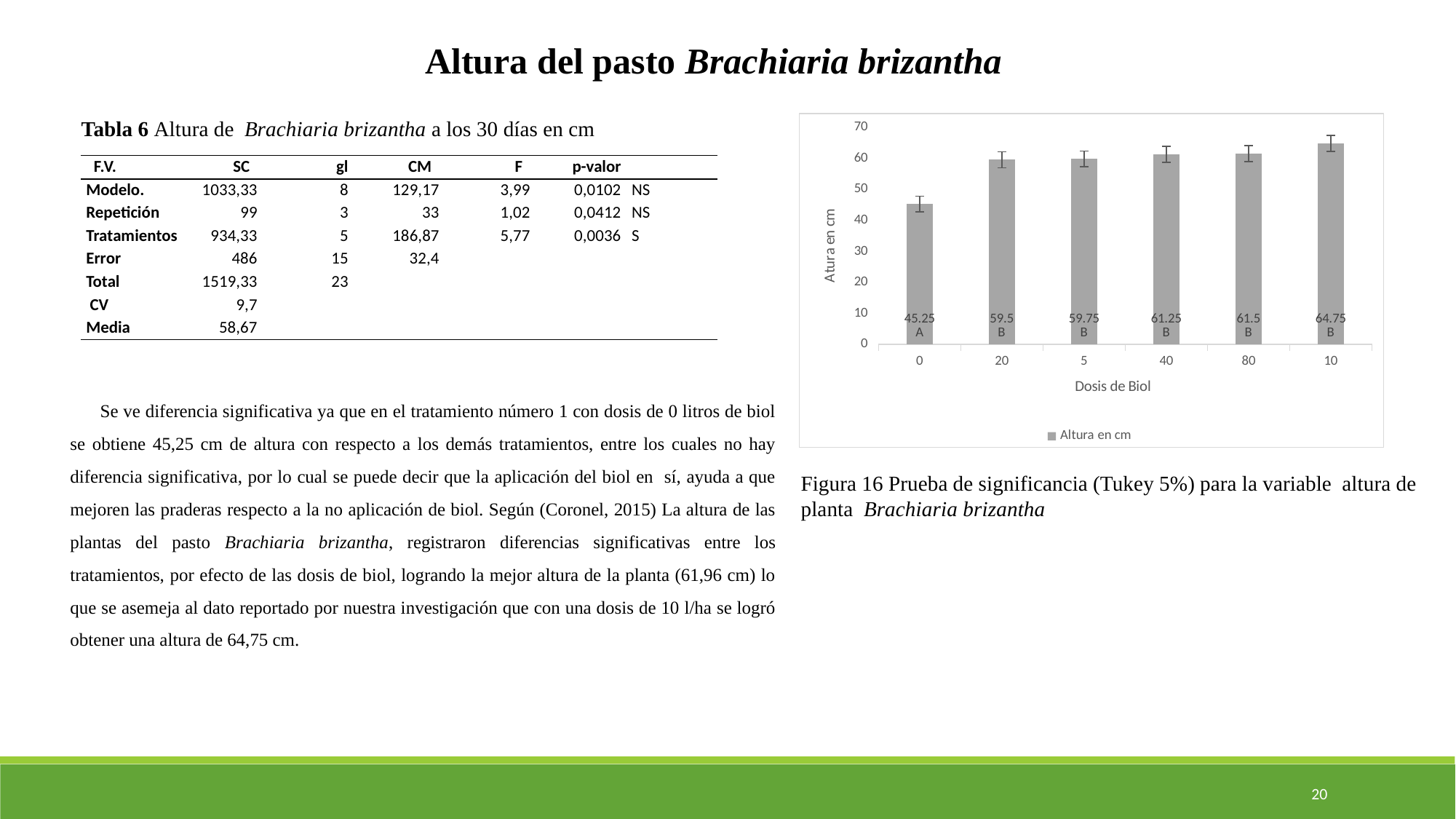
Which Biol dose has the lowest height in cm? 0 What is the height in cm for the Biol dose of 10? 64.75 Is the height for the Biol dose of 80 greater or less than 50? greater Which Biol dose has the highest height in cm? 10 What is the height in cm for the Biol dose of 40? 61.25 How many series does the chart legend list? 1 Which has a greater height: the Biol dose of 20 or the Biol dose of 0? 20 What is the difference in height between the Biol dose of 10 and the Biol dose of 0? 19.5 What is the x-axis title of the chart? Dosis de Biol What kind of chart is shown on the slide? bar chart How many Biol dose categories are shown on the x axis? 6 What is the height in cm for the Biol dose of 0? 45.25